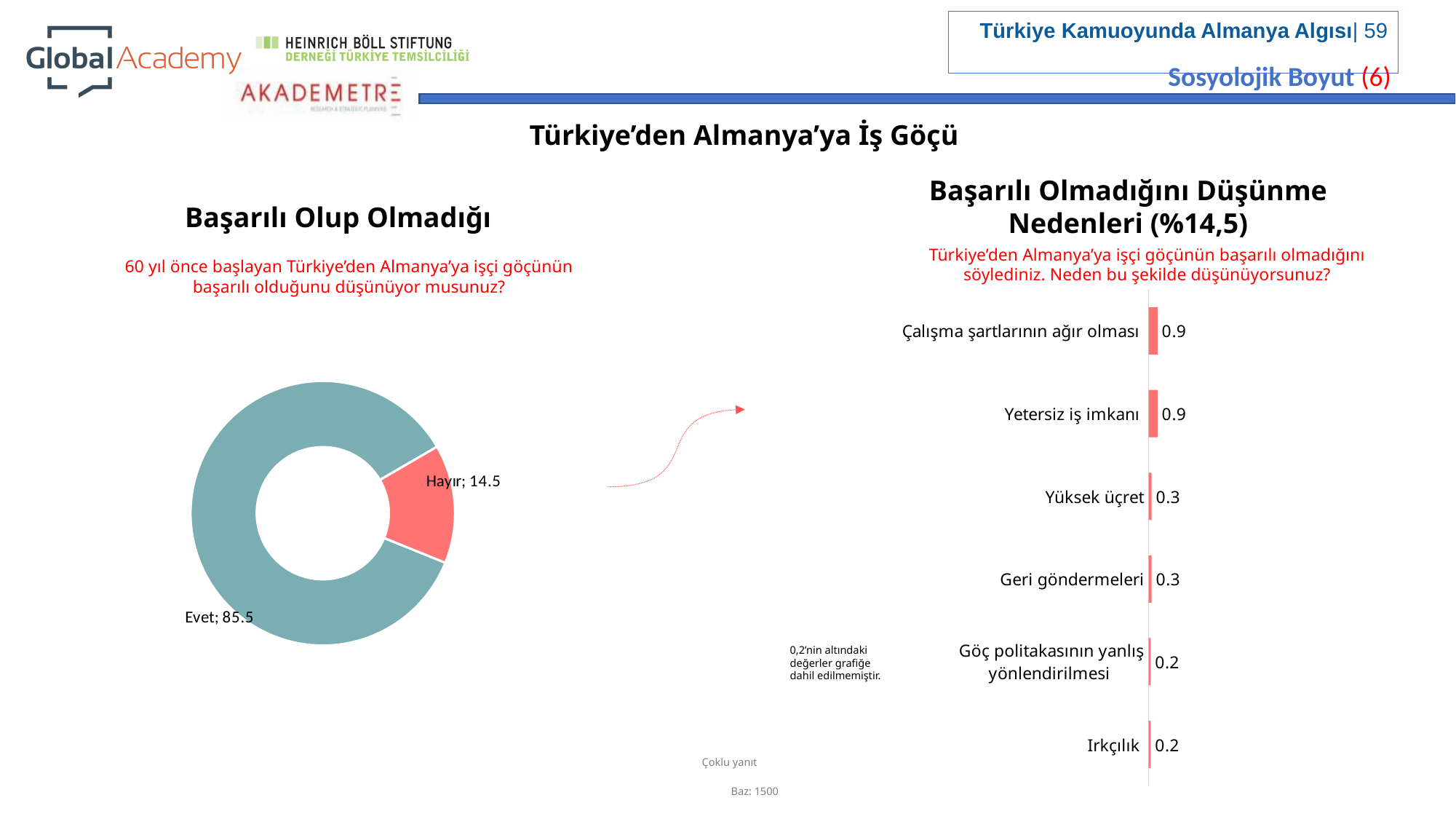
In the 'Başarılı Olup Olmadığı' chart, what is the value for Hayır? 14.5 In the 'Başarılı Olmadığını Düşünme Nedenleri' chart, what is the value for Yetersiz iş imkanı? 0.9 In the 'Başarılı Olmadığını Düşünme Nedenleri' chart, what is the value for Irkçılık? 0.2 In the 'Başarılı Olmadığını Düşünme Nedenleri' chart, what is the difference between Yetersiz iş imkanı and Göç politakasının yanlış yönlendirilmesi? 0.7 In the 'Başarılı Olmadığını Düşünme Nedenleri' chart, which is larger: Çalışma şartlarının ağır olması or Yüksek ücret? Çalışma şartlarının ağır olması In the 'Başarılı Olup Olmadığı' chart, what is the value for Evet? 85.5 What kind of chart is the 'Başarılı Olup Olmadığı' chart? Donut (pie) chart In the 'Başarılı Olmadığını Düşünme Nedenleri' chart, how many categories are shown? 6 In the 'Başarılı Olup Olmadığı' chart, what is the difference between Evet and Hayır? 71 In the 'Başarılı Olmadığını Düşünme Nedenleri' chart, what is the value for Geri göndermeleri? 0.3 What kind of chart is the 'Başarılı Olmadığını Düşünme Nedenleri' chart? Bar chart In the 'Başarılı Olup Olmadığı' chart, which category has the largest share? Evet